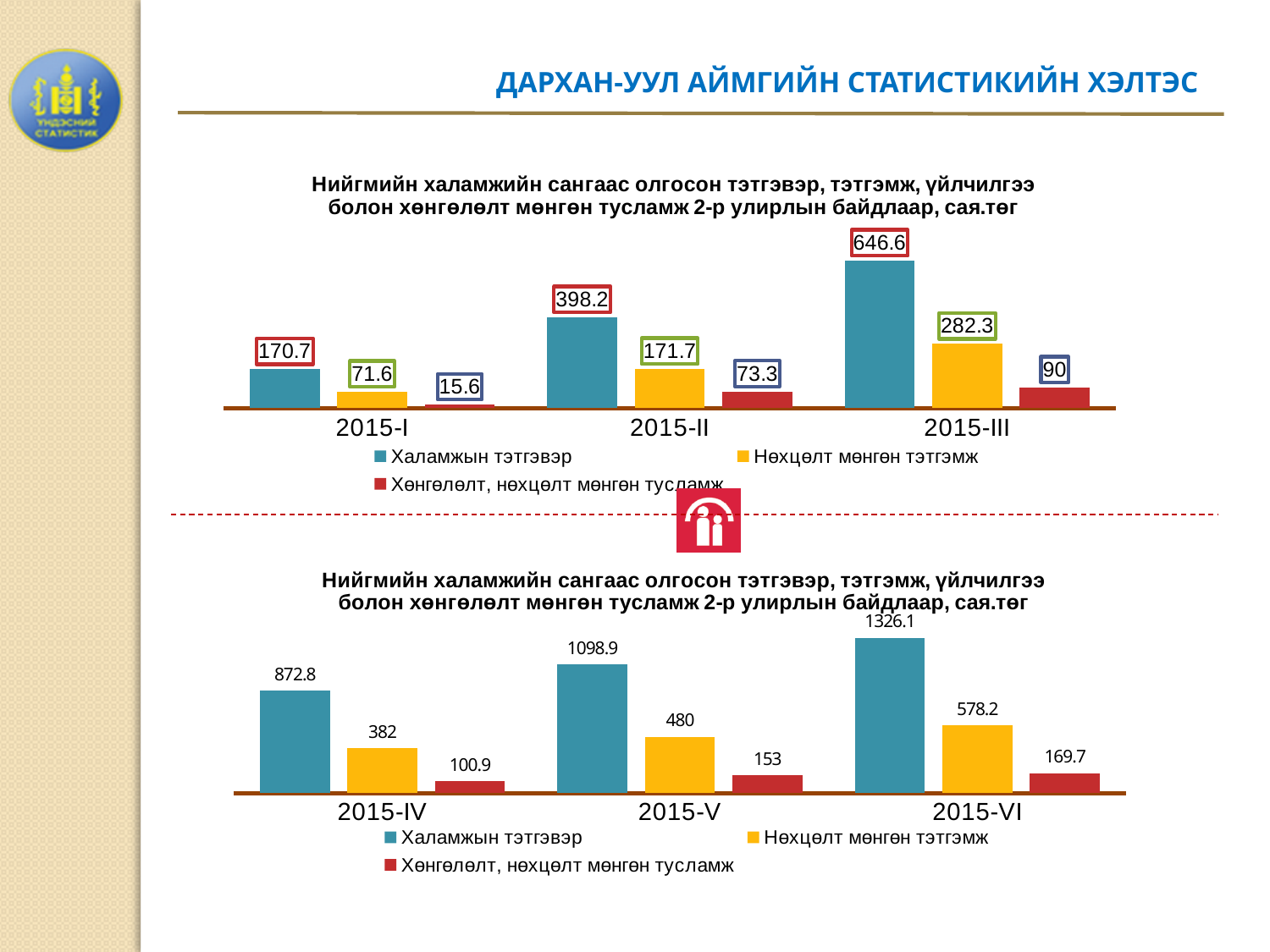
In the top chart, does Халамжын тэтгэвэр rise or fall from 2015-I to 2015-III? rise In the bottom chart, which period has the lowest value for Нөхцөлт мөнгөн тэтгэмж? 2015-IV In the top chart, what is the value of Халамжын тэтгэвэр for 2015-III? 646.6 In the top chart, what is the value of Нөхцөлт мөнгөн тэтгэмж for 2015-II? 171.7 In the bottom chart, which is larger: Хөнгөлөлт, нөхцөлт мөнгөн тусламж for 2015-V or for 2015-IV? 2015-V In the bottom chart, what is the difference between Нөхцөлт мөнгөн тэтгэмж for 2015-VI and 2015-V? 98.2 In the top chart, what is the value of Хөнгөлөлт, нөхцөлт мөнгөн тусламж for 2015-I? 15.6 In the top chart, what is the difference between Халамжын тэтгэвэр for 2015-III and 2015-II? 248.4 In the bottom chart, what is the value of Халамжын тэтгэвэр for 2015-V? 1098.9 In the top chart, which period has the highest value for Халамжын тэтгэвэр? 2015-III How many series does the legend of the top chart list? 3 In the bottom chart, what is the value of Хөнгөлөлт, нөхцөлт мөнгөн тусламж for 2015-VI? 169.7